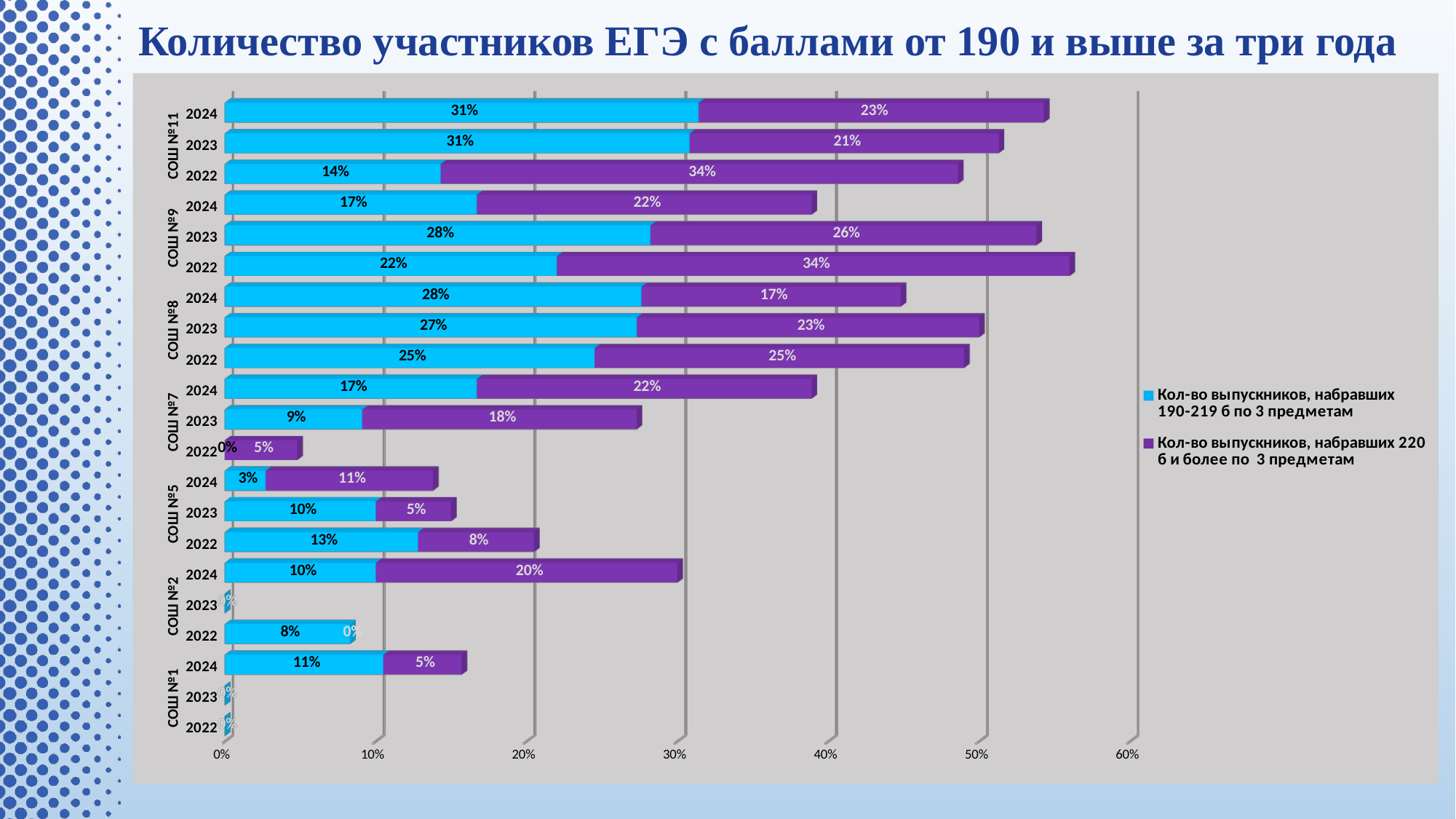
How many series does the legend list? 2 What is the value for the 190-219 points series for СОШ №11 in 2024? 31% What is the difference between the 190-219 points value and the 220 points and more value for СОШ №11 in 2022? 20% What is the total of the stacked bar for СОШ №9 in 2022? 56% How many schools are shown on the chart? 7 Which is larger for СОШ №7 in 2023: the 190-219 points value or the 220 points and more value? 220 points and more (18%) What is the title of the chart? Количество участников ЕГЭ с баллами от 190 и выше за три года What is the total of the stacked bar for СОШ №8 in 2023? 50% What is the value for the 220 points and more series for СОШ №9 in 2022? 34% What is the value for the 220 points and more series for СОШ №2 in 2024? 20% What kind of chart is shown on the slide? Stacked bar chart What is the value for the 190-219 points series for СОШ №5 in 2024? 3%